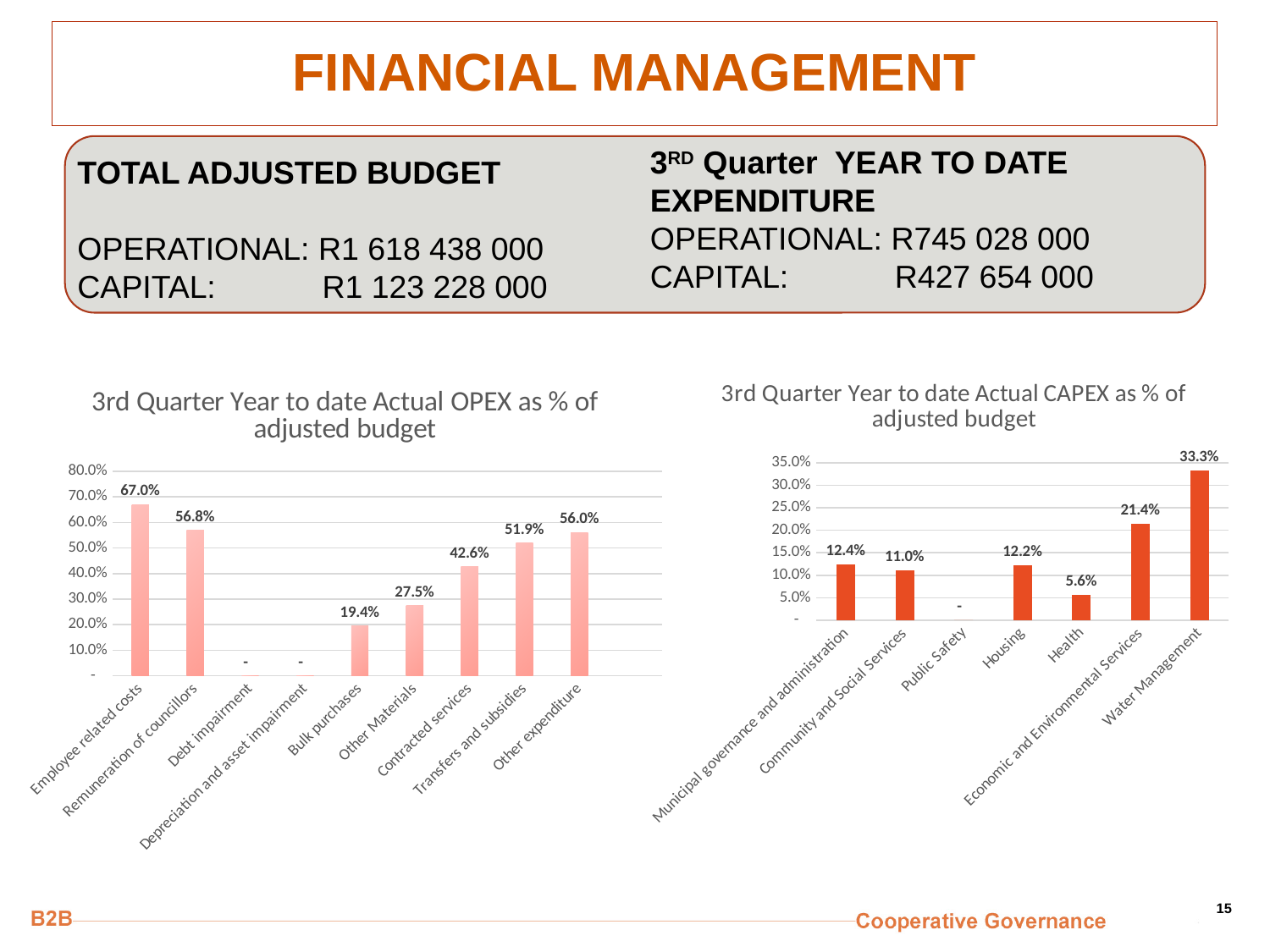
In the '3rd Quarter Year to date Actual OPEX as % of adjusted budget' chart, which is larger: Transfers and subsidies or Other Materials? Transfers and subsidies In the '3rd Quarter Year to date Actual OPEX as % of adjusted budget' chart, what is the difference between Remuneration of councillors and Bulk purchases? 37.4% In the '3rd Quarter Year to date Actual OPEX as % of adjusted budget' chart, what is the value for Contracted services? 42.6% In the '3rd Quarter Year to date Actual OPEX as % of adjusted budget' chart, what is the value for Employee related costs? 67.0% In the '3rd Quarter Year to date Actual OPEX as % of adjusted budget' chart, which category has the highest value? Employee related costs In the '3rd Quarter Year to date Actual CAPEX as % of adjusted budget' chart, what is the value for Health? 5.6% How many categories are shown on the x axis of the '3rd Quarter Year to date Actual CAPEX as % of adjusted budget' chart? 7 In the '3rd Quarter Year to date Actual CAPEX as % of adjusted budget' chart, which category has the highest value? Water Management How many categories are shown on the x axis of the '3rd Quarter Year to date Actual OPEX as % of adjusted budget' chart? 9 In the '3rd Quarter Year to date Actual CAPEX as % of adjusted budget' chart, what is the value for Water Management? 33.3% In the '3rd Quarter Year to date Actual CAPEX as % of adjusted budget' chart, what is the difference between Economic and Environmental Services and Community and Social Services? 10.4% What type of chart is the '3rd Quarter Year to date Actual CAPEX as % of adjusted budget' chart? Bar chart